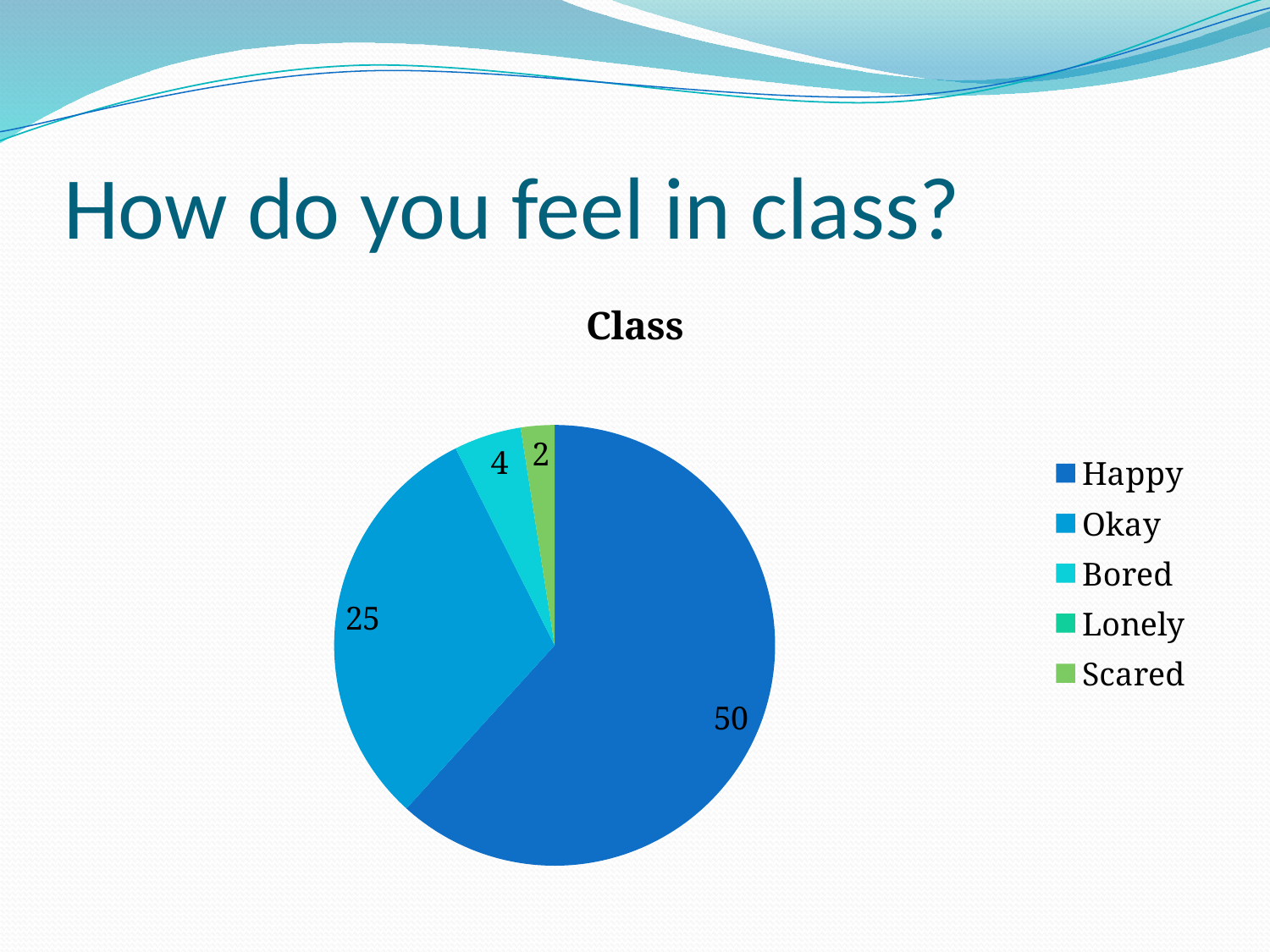
What value is shown for the Scared slice of the pie chart? 2 What is the difference between the Okay value and the Bored value? 21 Which category is listed first in the legend? Happy How many categories does the legend of the pie chart list? 5 What value is shown for the Okay slice of the pie chart? 25 What kind of chart is shown on the slide? Pie chart What value is shown for the Bored slice of the pie chart? 4 What value is shown for the Happy slice of the pie chart? 50 What is the difference between the Happy value and the Okay value? 25 Which category has the largest slice of the pie chart? Happy What is the title of the chart? Class Which is larger, the Bored slice or the Scared slice? Bored